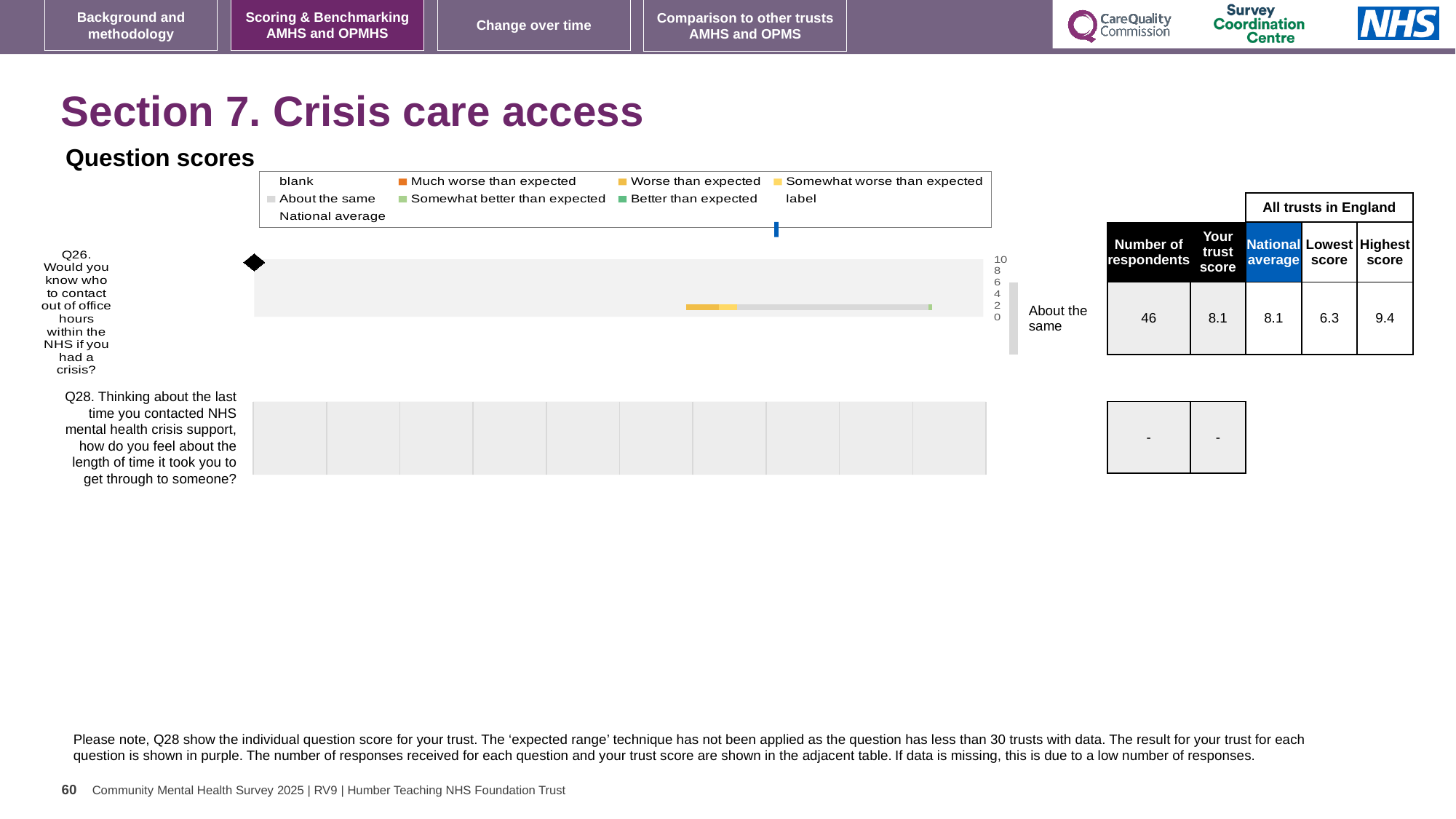
What is the lowest score among all trusts in England for Q26? 6.3 Which colour in the legend represents 'Much worse than expected'? orange How many questions are plotted in the question scores chart? 2 What is the difference between the highest score and the lowest score for Q26? 3.1 What is your trust score for Q26? 8.1 Which expected-range category is shown for Q26 in the question scores chart? About the same What is the difference between your trust score and the national average for Q26? 0 What kind of chart is used to show the question scores on this slide? bar chart What is the number of respondents for Q26 in the table next to the chart? 46 What is the highest score among all trusts in England for Q26? 9.4 What is the national average for Q26? 8.1 What is shown in the table for the number of respondents for Q28? -